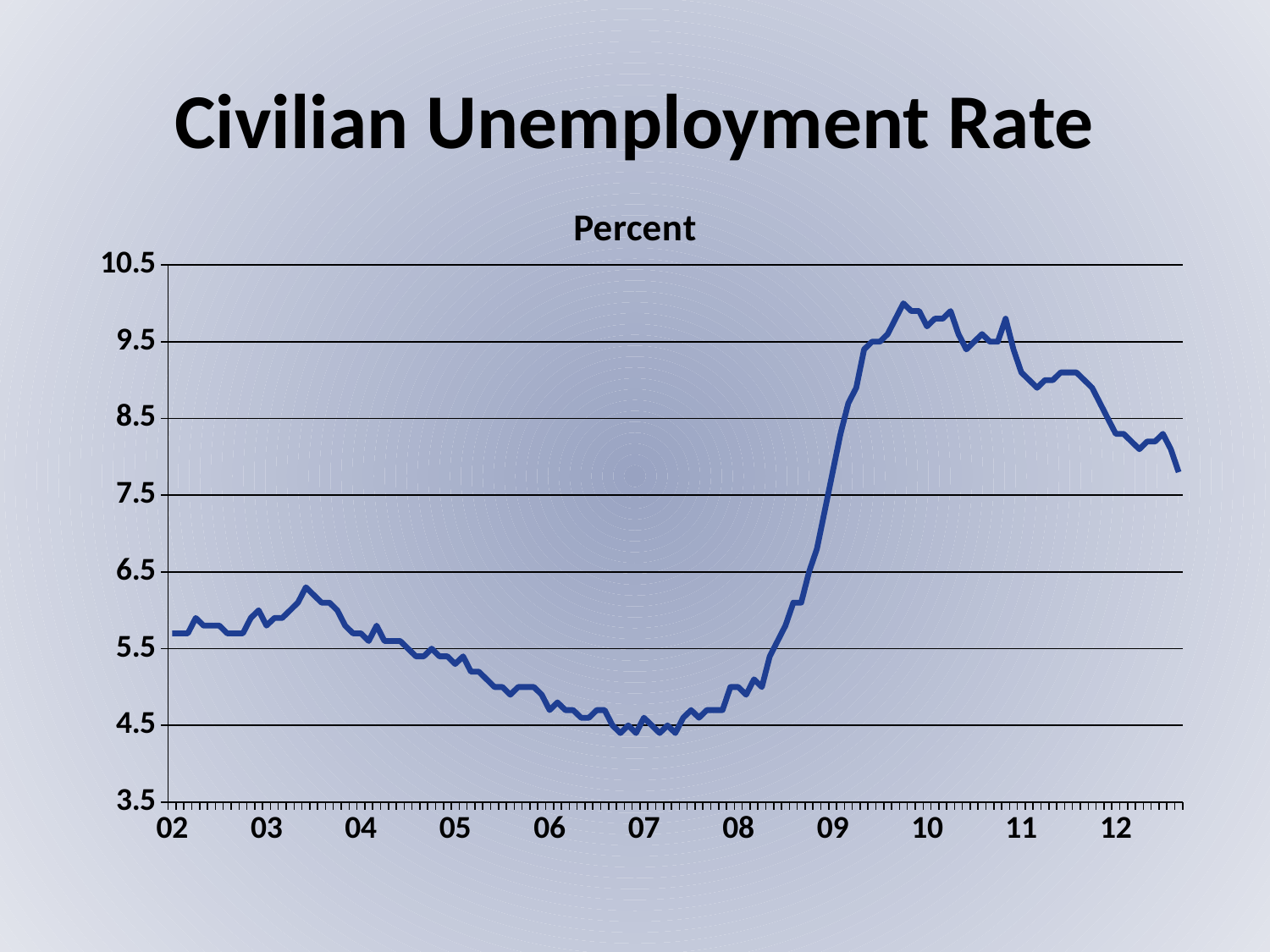
Is the lowest point of the line greater or less than 4.5? less Does the unemployment rate rise or fall between the 08 and 09 labels? rise What unit label appears above the chart's plot area? Percent Is the value at the 07 label greater or less than 5.5? less What is the title of the slide's chart? Civilian Unemployment Rate Does the unemployment rate rise or fall between the 10 and 12 labels? fall Is the value at the 09 label larger or smaller than the value at the 07 label? larger Is the value at the start of the series (02) greater or less than 6.5? less How many year labels are shown along the x axis? 11 What kind of chart is shown on the slide? line chart